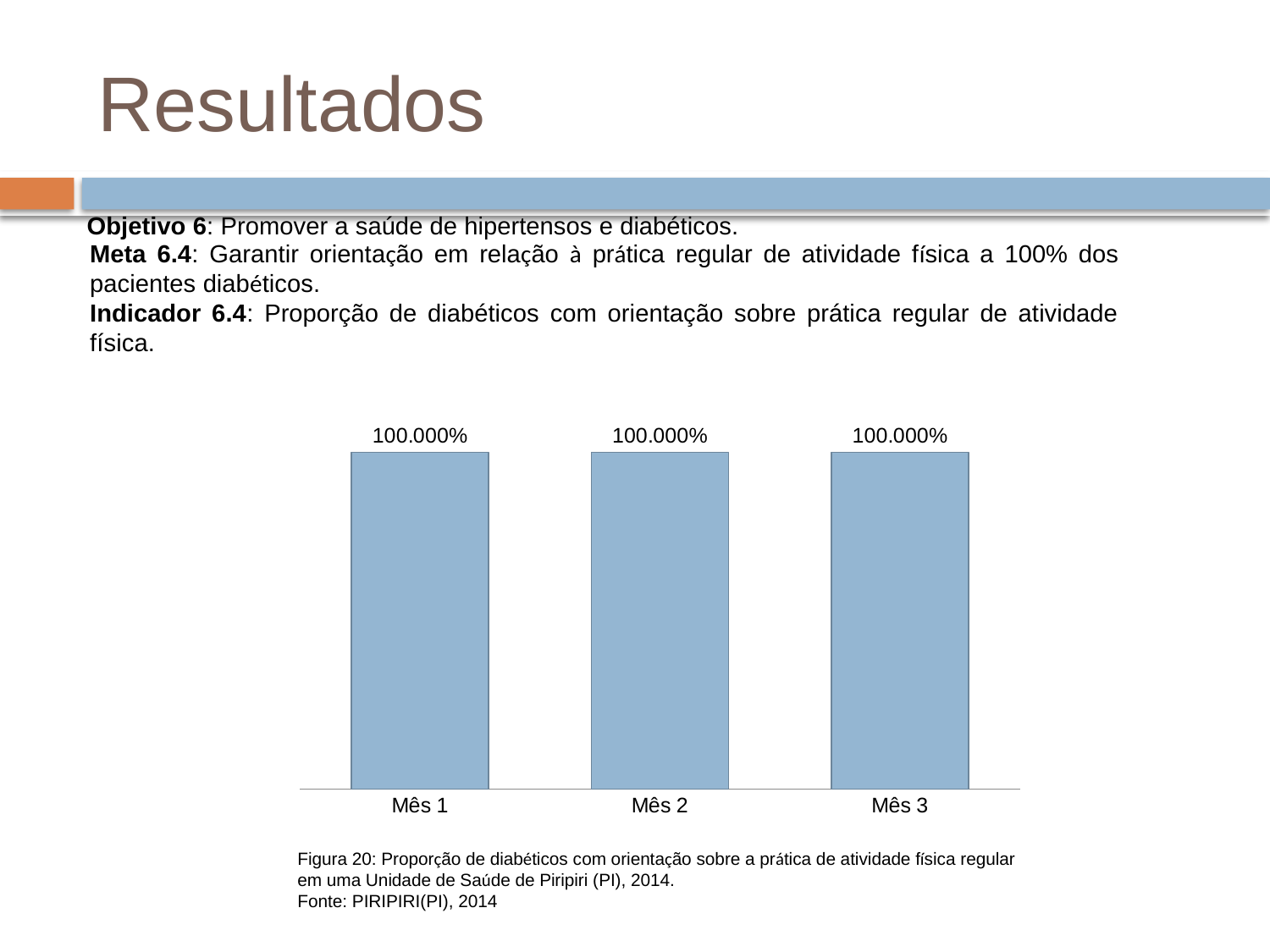
Is the value for Mês 2 larger than, smaller than, or equal to the value for Mês 3? equal What is the difference between the values for Mês 1 and Mês 3? 0.000% What is the value for Mês 2? 100.000% Do the values rise, fall or stay the same from Mês 1 to Mês 3? stay the same What is the value for Mês 1? 100.000% What is the value for Mês 3? 100.000% What is the label of the first category on the x axis? Mês 1 What kind of chart is shown on the slide? bar chart How many categories are shown on the x axis of the chart? 3 What figure number is given in the caption below the chart? Figura 20